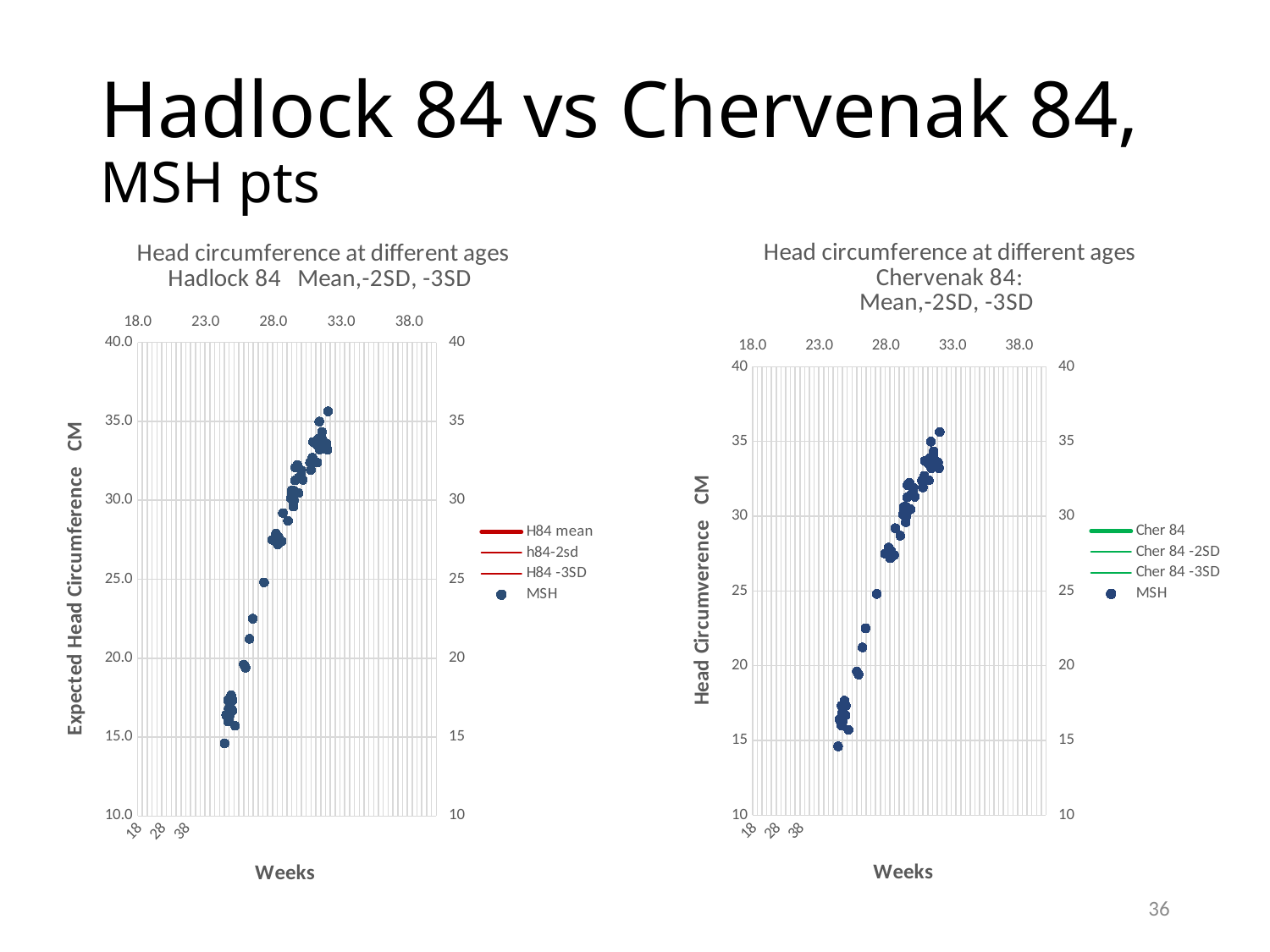
In the left (Hadlock 84) chart, do the MSH points rise or fall as weeks increase along the x axis? rise What is the x-axis title of the left (Hadlock 84) chart? Weeks In the right (Chervenak 84) chart, is the highest MSH point greater or less than 30? greater In the right (Chervenak 84) chart, do the MSH points rise or fall as weeks increase along the x axis? rise What is the y-axis title of the left (Hadlock 84) chart? Expected Head Circumference CM What kind of chart is the left chart, titled 'Head circumference at different ages Hadlock 84 Mean,-2SD, -3SD'? scatter chart How many series does the legend of the right (Chervenak 84) chart list? 4 In the left (Hadlock 84) chart, is the lowest MSH point greater or less than 20? less How many series does the legend of the left (Hadlock 84) chart list? 4 What kind of chart is the right chart, titled 'Head circumference at different ages Chervenak 84: Mean,-2SD, -3SD'? scatter chart